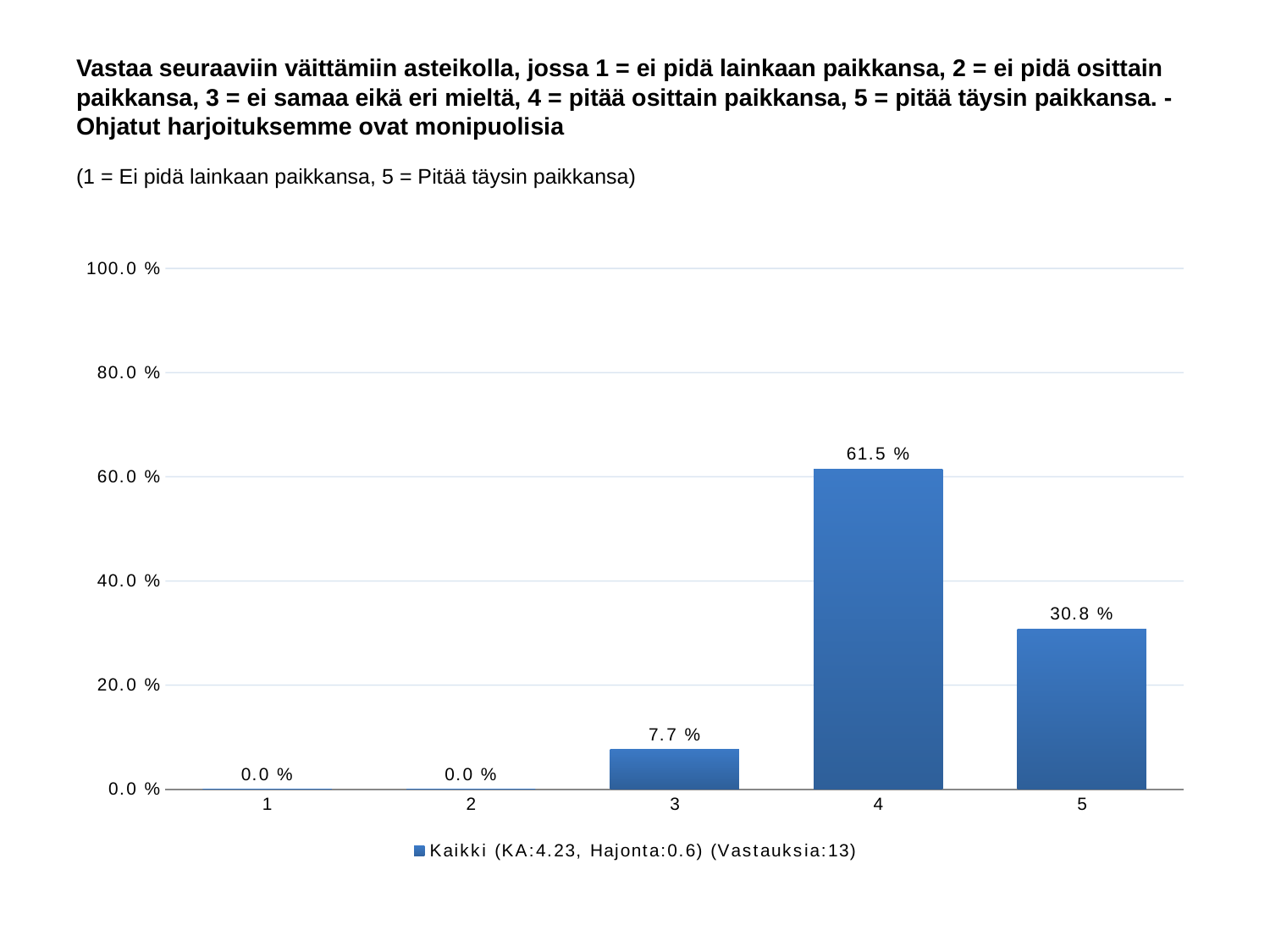
Which is larger, the value for category 3 or the value for category 5? 5 What is the number of responses (Vastauksia) given in the legend? 13 What kind of chart is shown on the slide? bar chart What is the value for category 3? 7.7 % What is the difference between the values for categories 4 and 5? 30.7 % What is the value for category 5? 30.8 % Which category has the highest value? 4 What is the value for category 1? 0.0 % How many series does the legend list? 1 Is the value for category 4 greater or less than 60.0 %? greater How many categories are shown on the x axis? 5 What is the value for category 4? 61.5 %